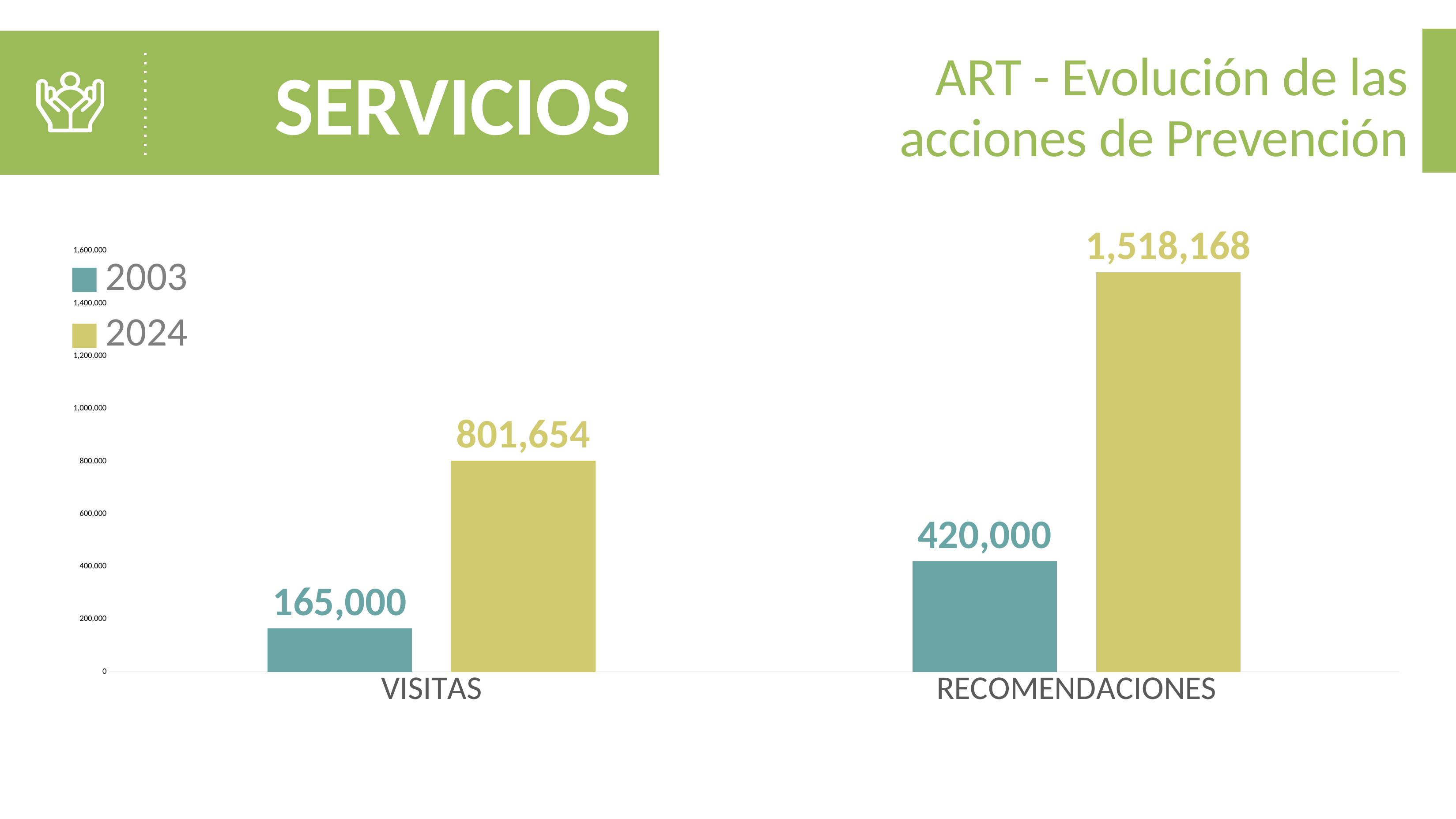
What is the value for VISITAS in 2003? 165,000 How many series does the legend list? 2 Which bar has the highest value on the chart? RECOMENDACIONES in 2024 How many categories are shown on the x axis? 2 What is the value for RECOMENDACIONES in 2003? 420,000 Which is larger: RECOMENDACIONES in 2003 or VISITAS in 2024? VISITAS in 2024 What is the difference between the 2024 and 2003 values for VISITAS? 636,654 Which bar has the lowest value on the chart? VISITAS in 2003 What is the difference between the 2024 and 2003 values for RECOMENDACIONES? 1,098,168 What is the value for RECOMENDACIONES in 2024? 1,518,168 What is the value for VISITAS in 2024? 801,654 What kind of chart is shown on the slide? Bar chart